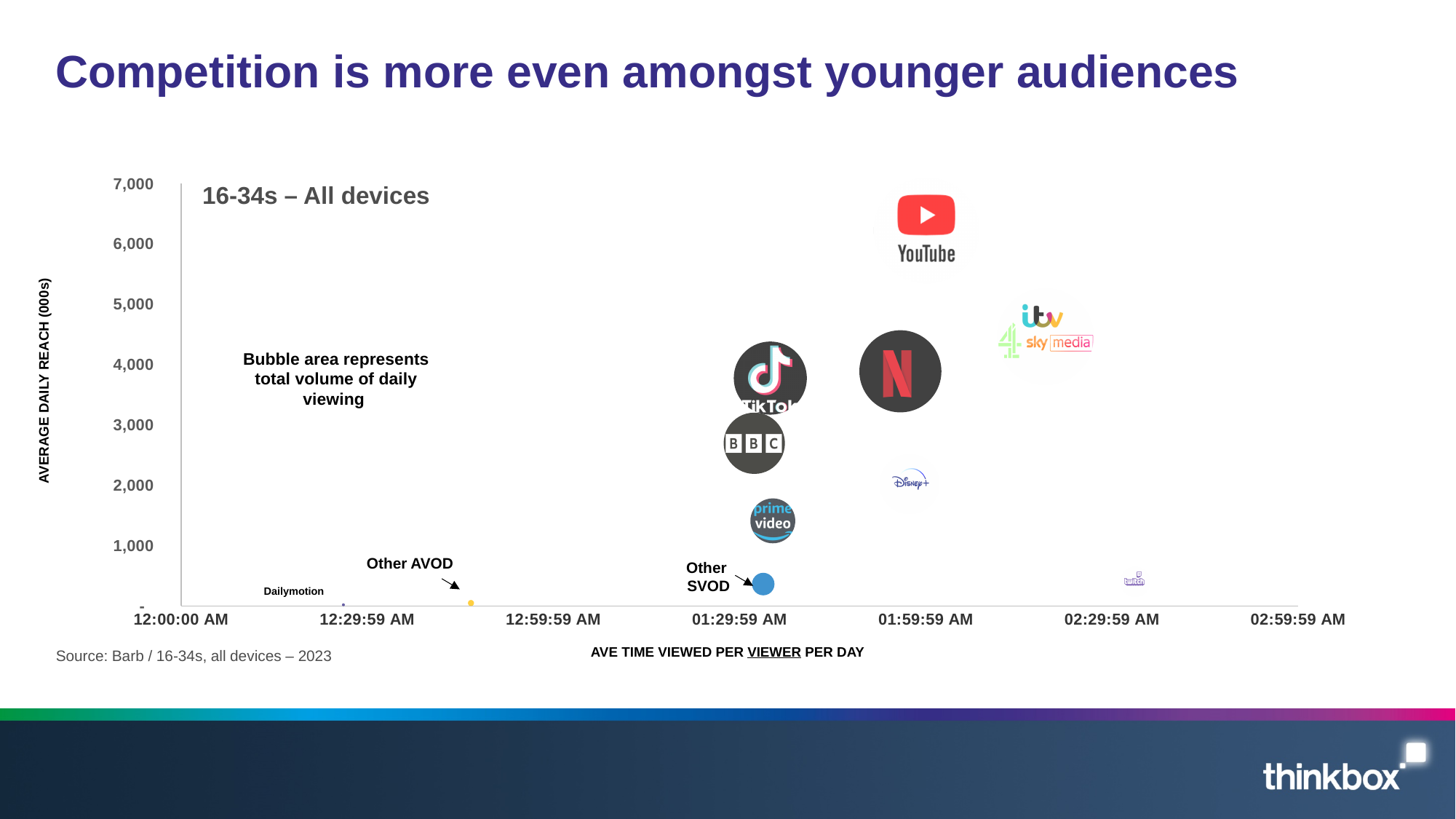
Is the average daily reach for Prime Video greater or less than 2,000? less Is the average daily reach for YouTube greater or less than 6,000? greater Which has the higher average time viewed per viewer per day, Twitch or Dailymotion? Twitch Is the average daily reach for Netflix greater or less than 3,000? greater Which platform has the highest average daily reach? YouTube What kind of chart is shown on the slide? Bubble chart Which has the higher average daily reach, YouTube or Netflix? YouTube Which platform has the lowest average daily reach? Dailymotion What audience group and device scope does the chart subtitle state? 16-34s – All devices According to the chart annotation, what does the bubble area represent? Total volume of daily viewing